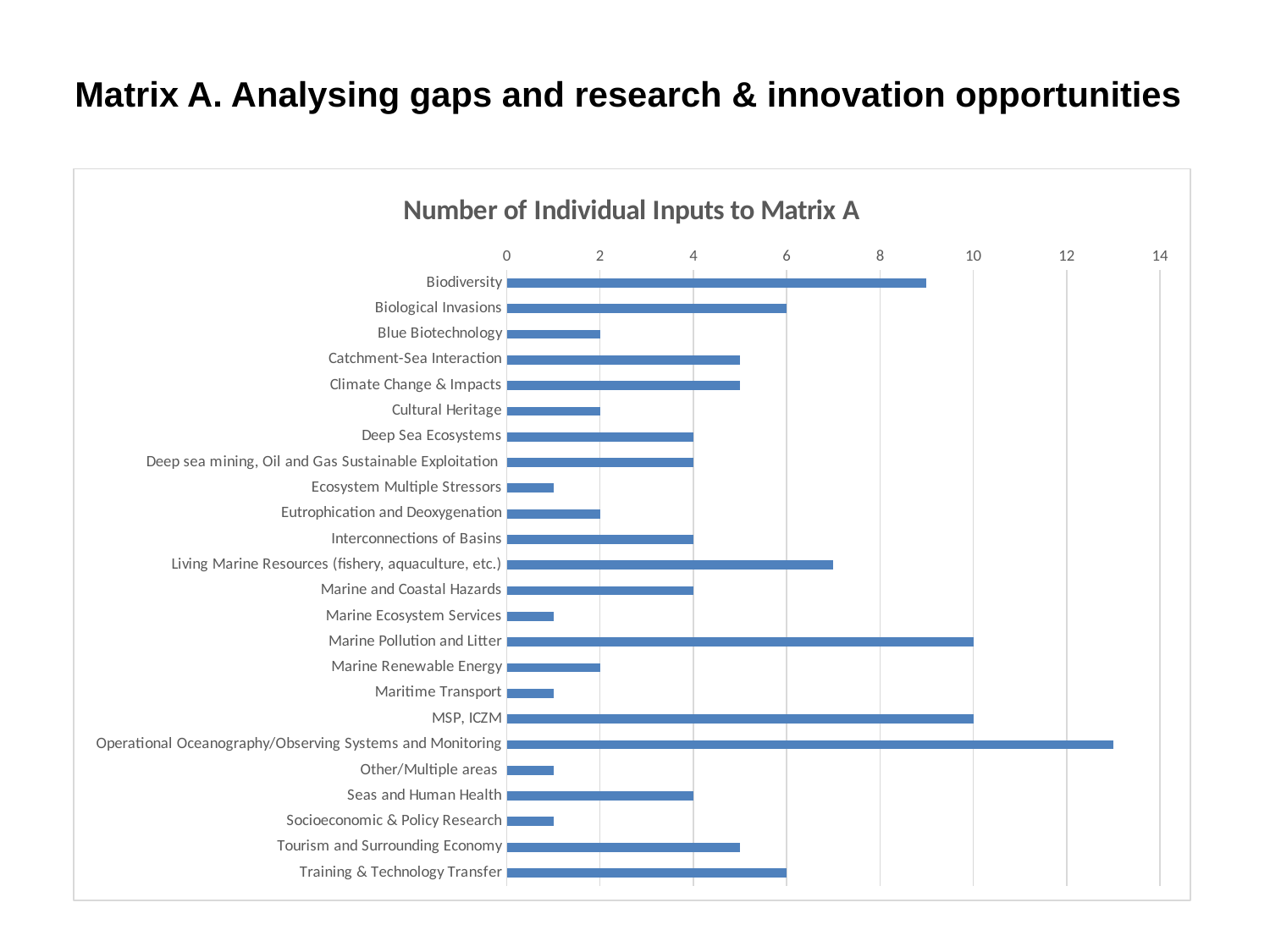
Which category has the highest number of individual inputs to Matrix A? Operational Oceanography/Observing Systems and Monitoring Is the value for Operational Oceanography/Observing Systems and Monitoring greater or less than 12? greater What type of chart is shown on the slide? bar chart What is the difference between the values for MSP, ICZM and Marine Renewable Energy? 8 What is the value for Biological Invasions? 6 Which has a larger value, Living Marine Resources (fishery, aquaculture, etc.) or Catchment-Sea Interaction? Living Marine Resources (fishery, aquaculture, etc.) How many categories are plotted in the chart? 24 What is the value for Marine Pollution and Litter? 10 What is the value for Blue Biotechnology? 2 What is the title of the chart? Number of Individual Inputs to Matrix A Is the value for Biodiversity greater or less than 8? greater What is the value for Seas and Human Health? 4